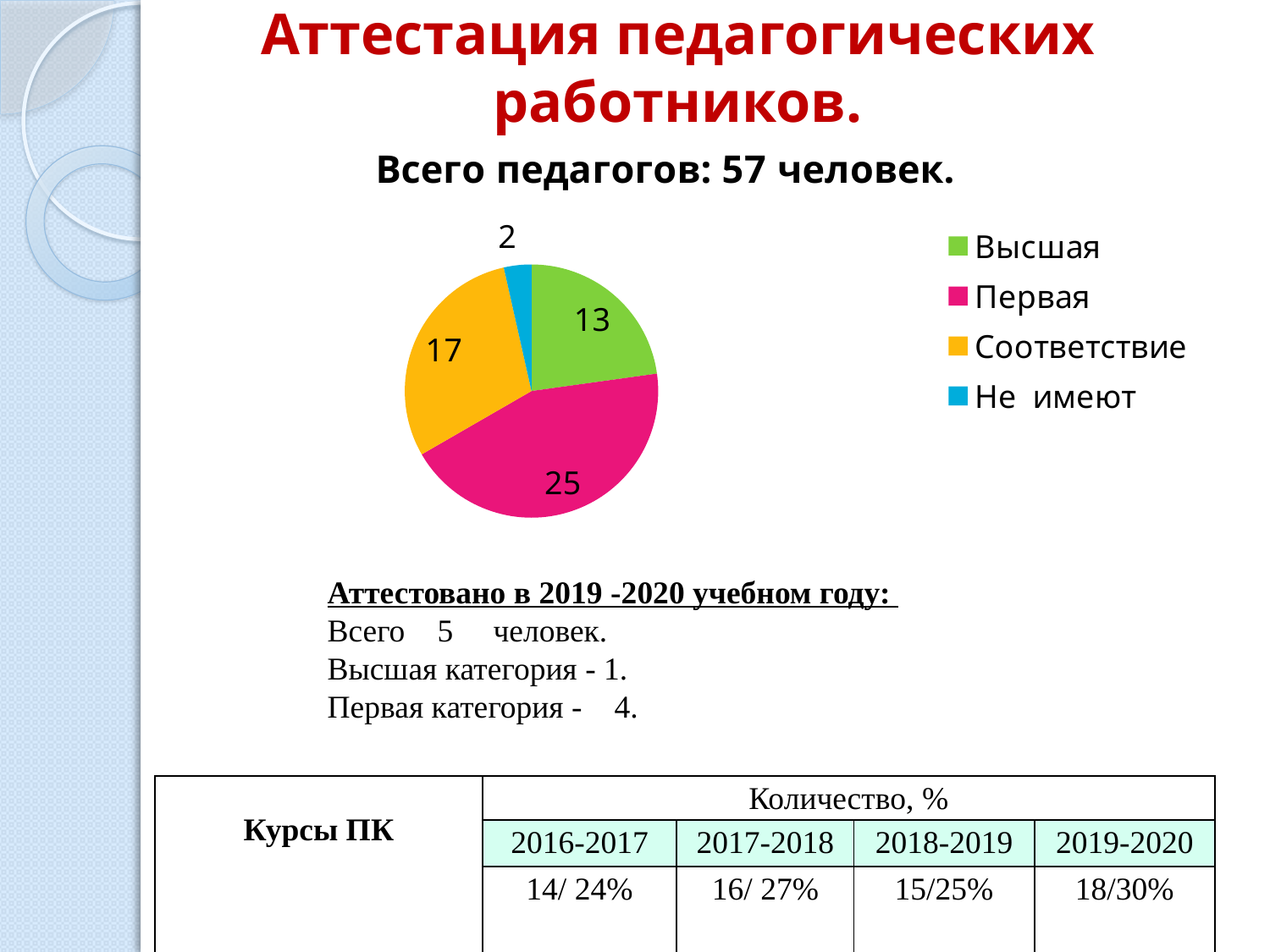
What is the difference between the Первая and Высшая values in the pie chart? 12 What colour is the Соответствие slice in the pie chart? Orange Which category has the largest slice in the pie chart? Первая What type of chart is shown on the slide? Pie chart Which is larger in the pie chart, Соответствие or Высшая? Соответствие How many entries does the legend of the pie chart list? 4 What value is shown for the Соответствие slice of the pie chart? 17 Which category has the smallest slice in the pie chart? Не имеют What value is shown for the Первая slice of the pie chart? 25 What value is shown for the Не имеют slice of the pie chart? 2 What value is shown for the Высшая slice of the pie chart? 13 How many slices does the pie chart have? 4